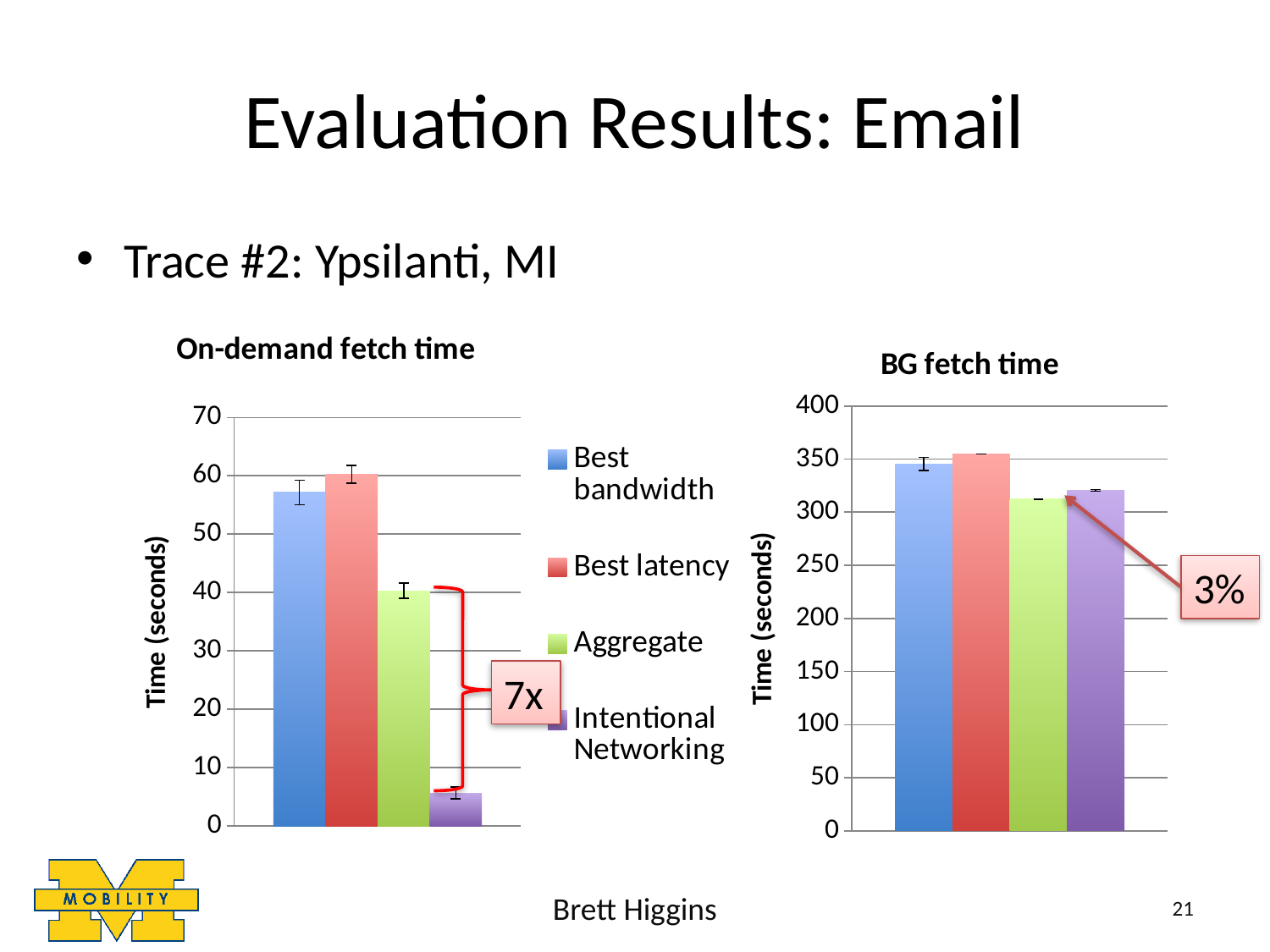
What is the y-axis label of the "BG fetch time" chart? Time (seconds) How many series does the legend of the "On-demand fetch time" chart list? 4 In the "BG fetch time" chart, which is larger, Best latency or Aggregate? Best latency In the "BG fetch time" chart, is the value for Aggregate greater or less than 350? less What kind of chart is the "On-demand fetch time" chart? bar chart In the "On-demand fetch time" chart, is the value for Best bandwidth greater or less than 50? greater In the "On-demand fetch time" chart, is the value for Intentional Networking greater or less than 10? less In the "On-demand fetch time" chart, which is larger, Aggregate or Intentional Networking? Aggregate In the "On-demand fetch time" chart, which series has the lowest value? Intentional Networking How many bars are plotted in the "BG fetch time" chart? 4